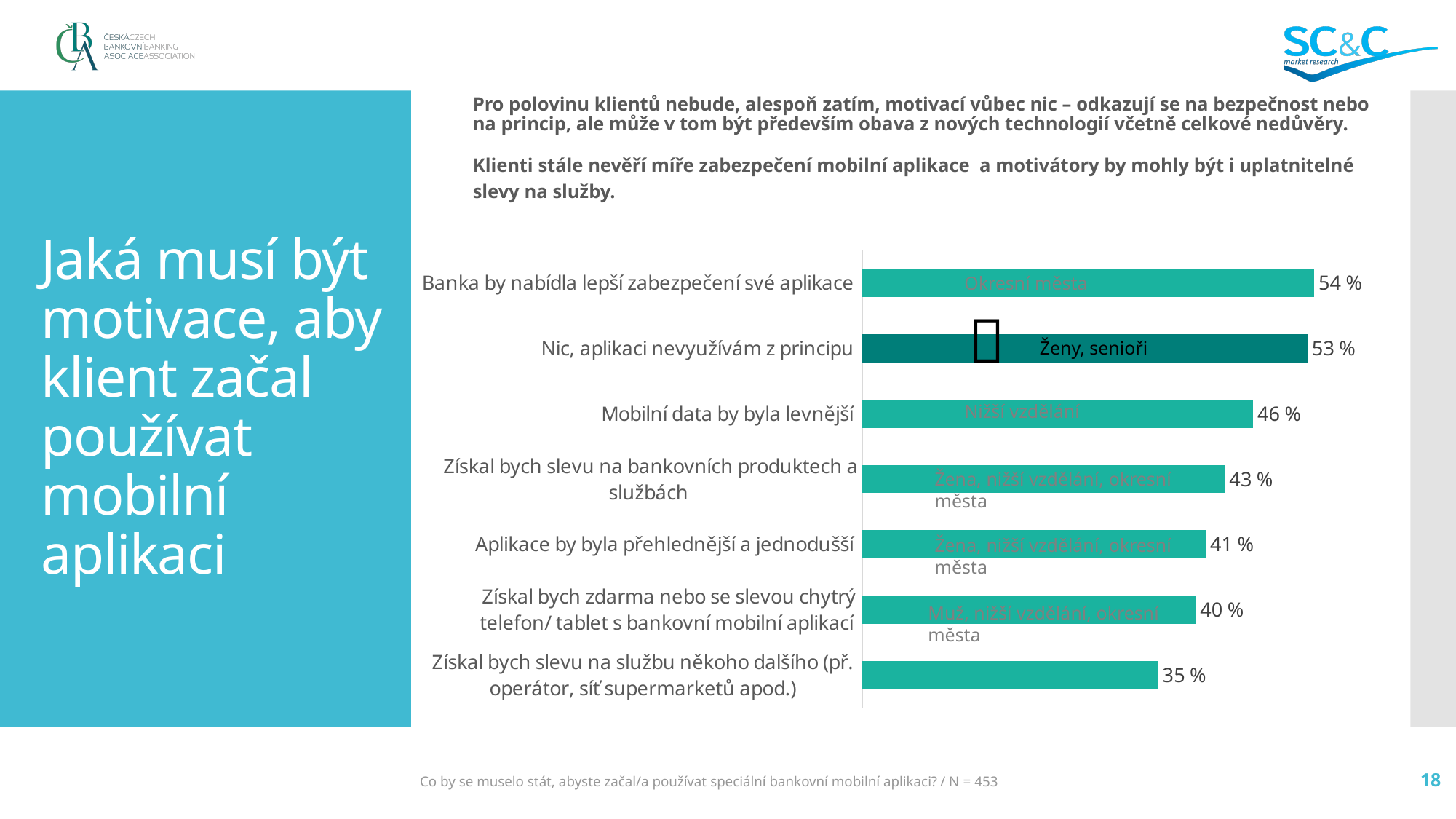
What is the value for "Nic, aplikaci nevyužívám z principu"? 53 % What kind of chart is shown on the slide? Bar chart How many categories are shown in the chart? 7 Do the values increase or decrease going from the top bar to the bottom bar? Decrease What is the value for "Aplikace by byla přehlednější a jednodušší"? 41 % Which category's bar is drawn in a darker colour than the others? Nic, aplikaci nevyužívám z principu Which is larger: the value for "Získal bych slevu na bankovních produktech a službách" or the value for "Získal bych zdarma nebo se slevou chytrý telefon/ tablet s bankovní mobilní aplikací"? Získal bych slevu na bankovních produktech a službách Which category has the highest value? Banka by nabídla lepší zabezpečení své aplikace What is the difference in percentage points between the highest value (54 %) and the lowest value (35 %)? 19 What is the value for "Banka by nabídla lepší zabezpečení své aplikace"? 54 % What is the value for "Mobilní data by byla levnější"? 46 % Which category has the lowest value? Získal bych slevu na službu někoho dalšího (př. operátor, síť supermarketů apod.)